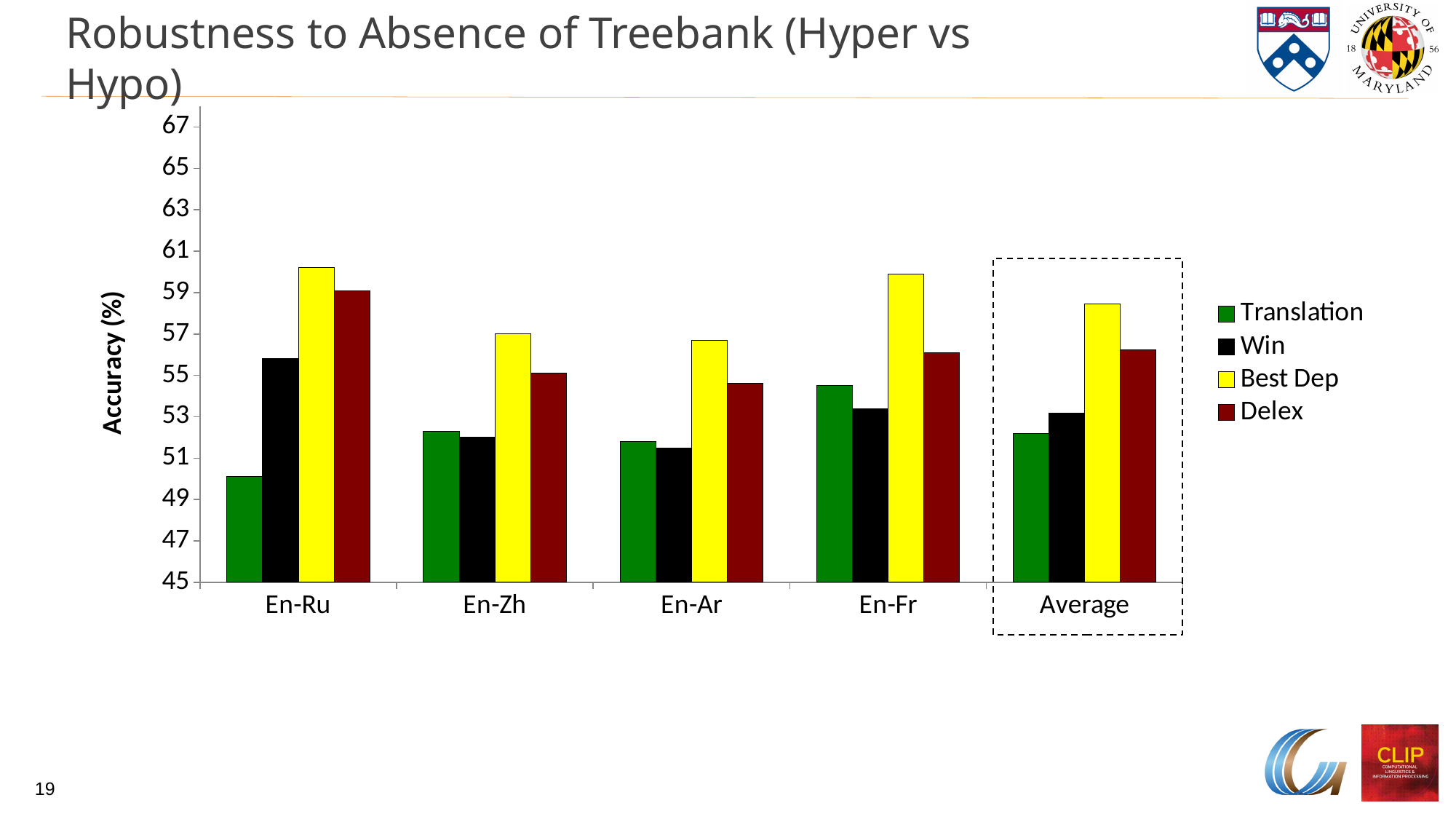
Which category has the lowest Translation value? En-Ru Is the Best Dep value for En-Ru greater or less than 59? greater How many categories are shown on the x axis? 5 Which series has the highest value for En-Ru? Best Dep What is the label of the y axis? Accuracy (%) Is the Translation value for En-Ru greater or less than 51? less Which category has the highest Delex value? En-Ru Which is larger for Average, Best Dep or Delex? Best Dep Is the Delex value for Average greater or less than 55? greater How many series does the legend list? 4 What kind of chart is shown on the slide? bar chart Which series has the lowest value for En-Ru? Translation